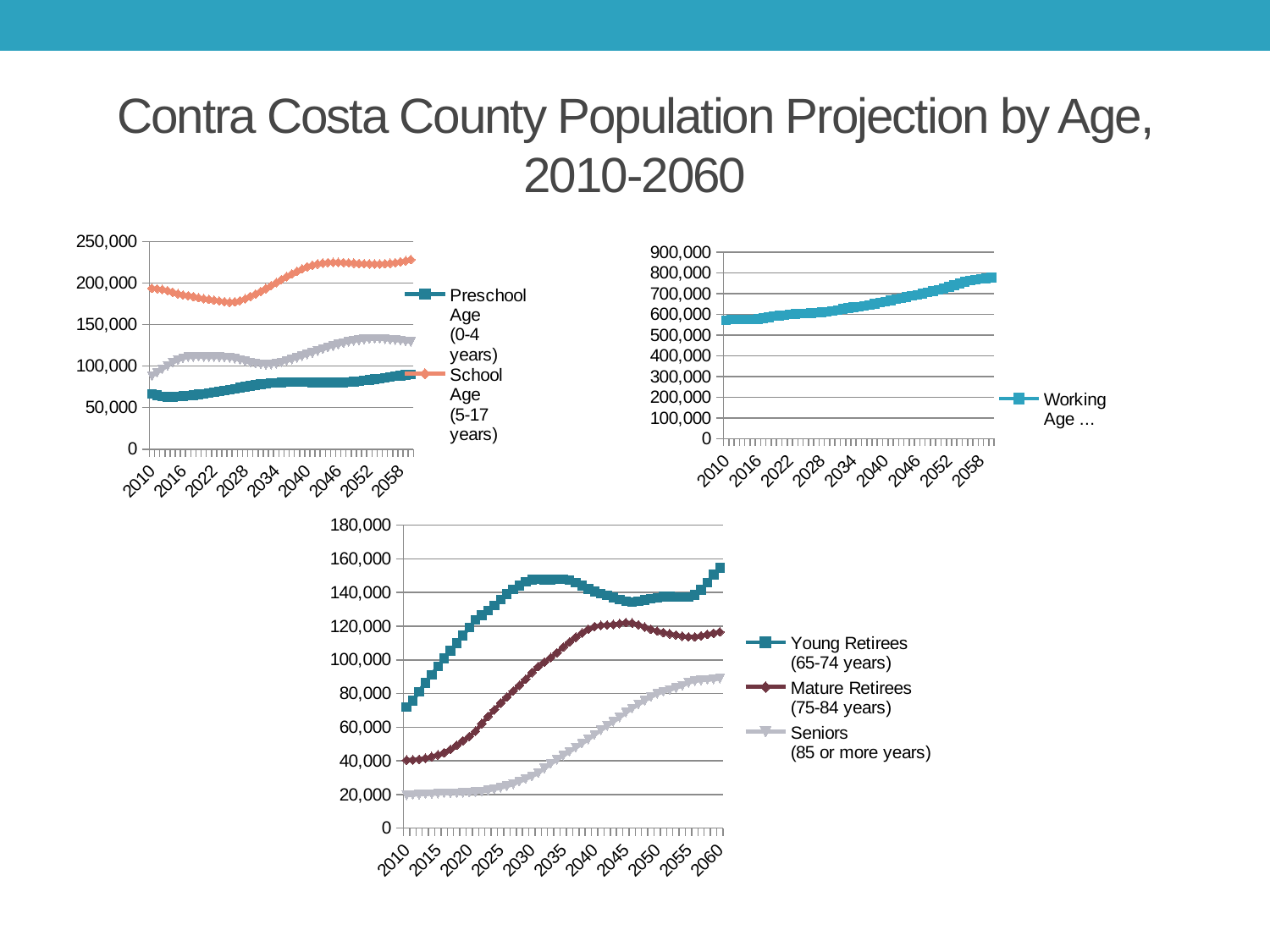
In the top-left chart, which is larger in 2010: Preschool Age (0-4 years) or School Age (5-17 years)? School Age (5-17 years) In the bottom chart, which is larger in 2060: Young Retirees or Mature Retirees? Young Retirees In the bottom chart, is the value for Young Retirees in 2010 greater or less than 80,000? less In the bottom chart, which series has the highest value in 2010? Young Retirees (65-74 years) In the top-right chart, is the Working Age value in 2010 greater or less than 500,000? greater In the top-left chart, is the value for School Age (5-17 years) in 2010 greater or less than 150,000? greater What type of chart is the top-right chart (Working Age)? Line chart In the bottom chart, which series has the lowest value in 2010? Seniors (85 or more years) In the bottom chart, how many series does the legend list? 3 In the top-right chart, does the Working Age population rise or fall from 2010 to 2060? Rises